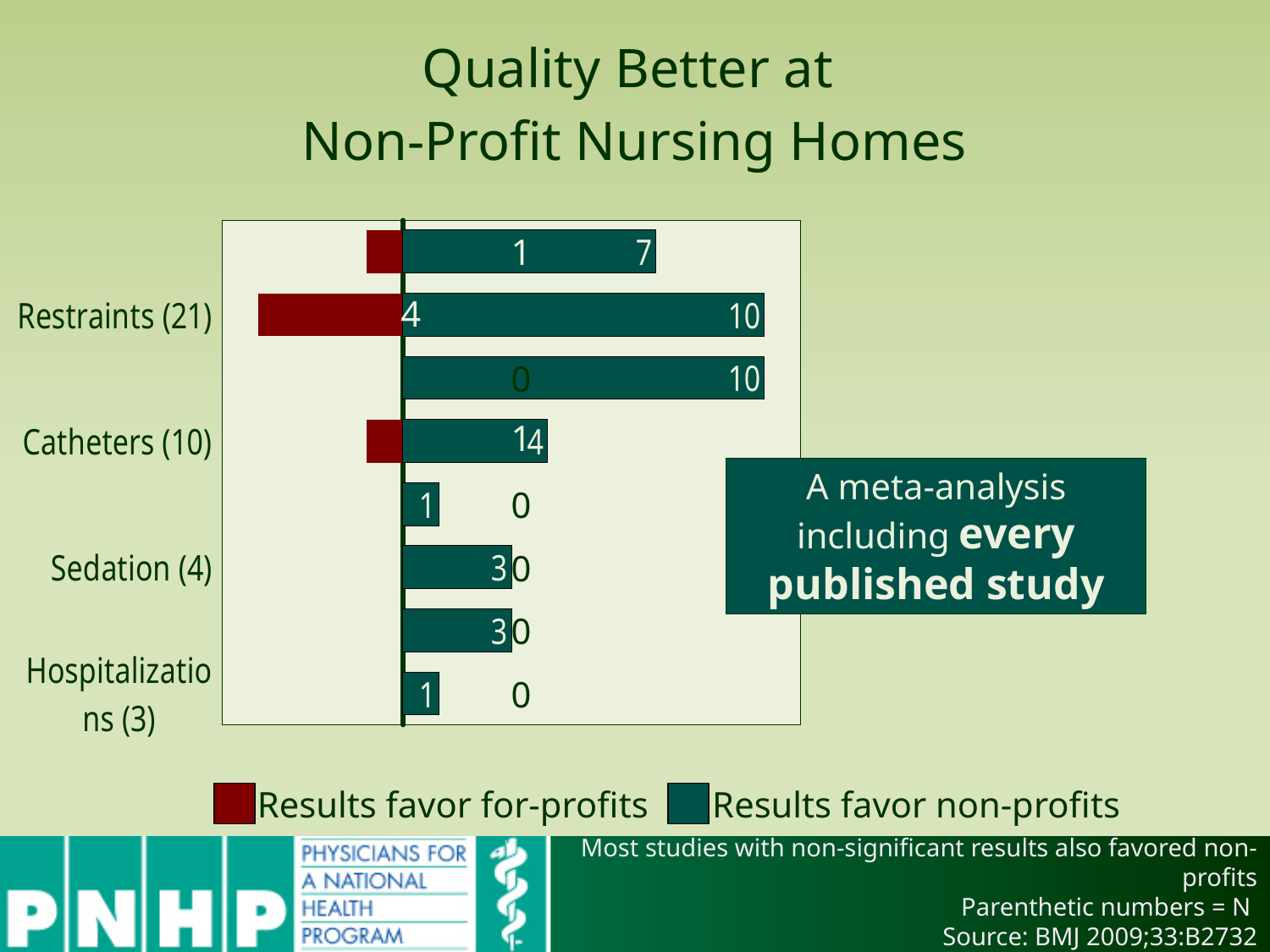
What kind of chart is shown on the slide? bar chart Among the labeled categories, which has the highest number of studies favoring non-profits? Restraints (21) How many series does the legend list? 2 How many studies favored for-profits for Restraints (21)? 4 For Restraints (21), what is the difference between the number of studies favoring non-profits and the number favoring for-profits? 6 For Restraints (21), which is larger: the number of studies favoring for-profits or the number favoring non-profits? Results favor non-profits How many studies favored non-profits for Sedation (4)? 3 How many studies favored non-profits for Restraints (21)? 10 How many studies favored for-profits for Hospitalizations (3)? 0 What is the title of the slide's chart? Quality Better at Non-Profit Nursing Homes Which legend entry is shown in dark red? Results favor for-profits How many studies favored non-profits for Hospitalizations (3)? 1